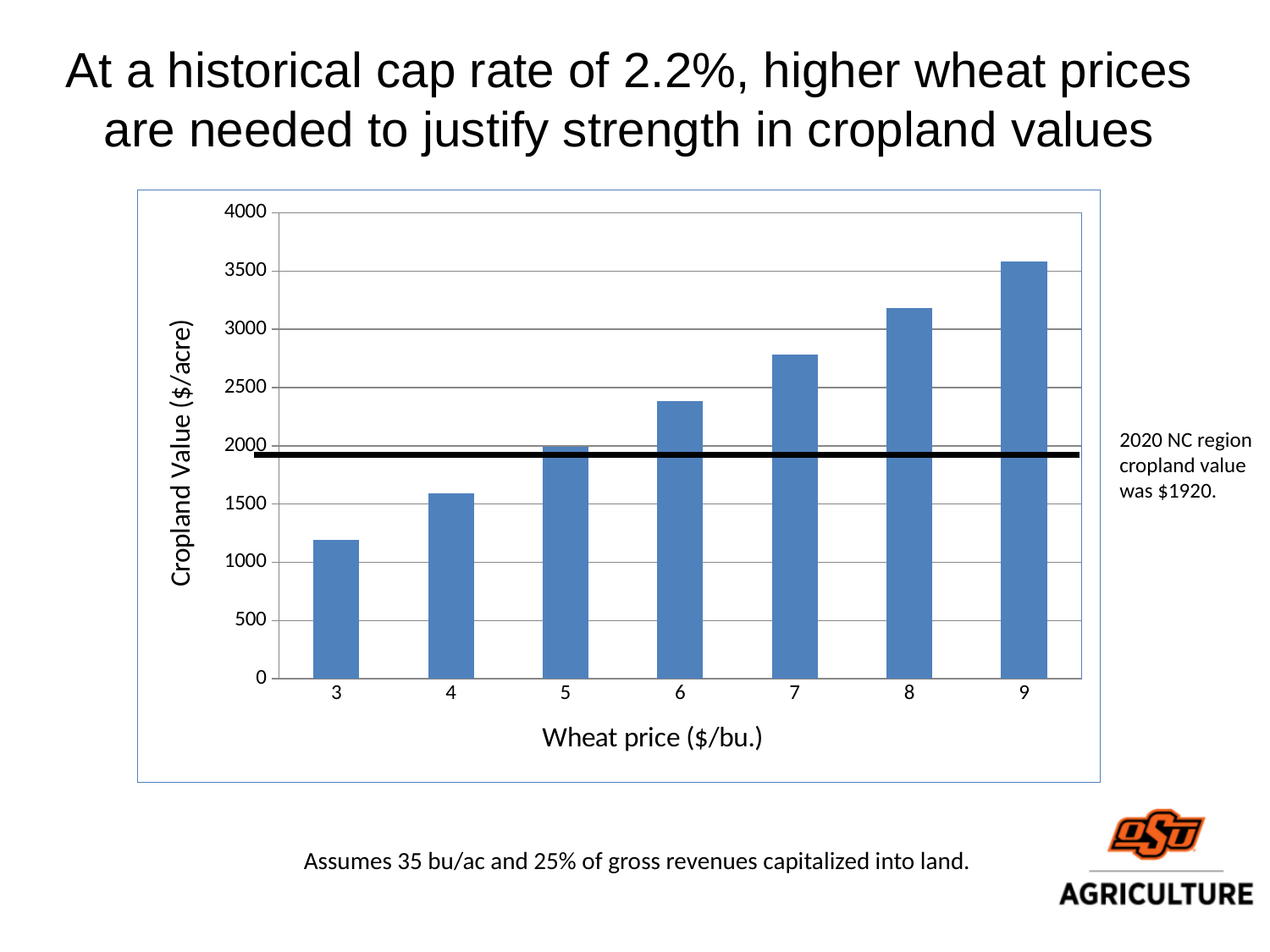
Is the cropland value at a wheat price of 6 greater or less than 2000? greater Is the cropland value at a wheat price of 7 greater or less than 2500? greater Is the cropland value at a wheat price of 9 greater or less than 3000? greater Do cropland values rise or fall as wheat price increases along the x axis? rise Which has the larger cropland value, a wheat price of 5 or a wheat price of 8? 8 Which wheat price has the highest cropland value? 9 How many wheat price categories are plotted on the x axis? 7 What is the label of the y axis? Cropland Value ($/acre) What kind of chart is shown on the slide? bar chart Which wheat price has the lowest cropland value? 3